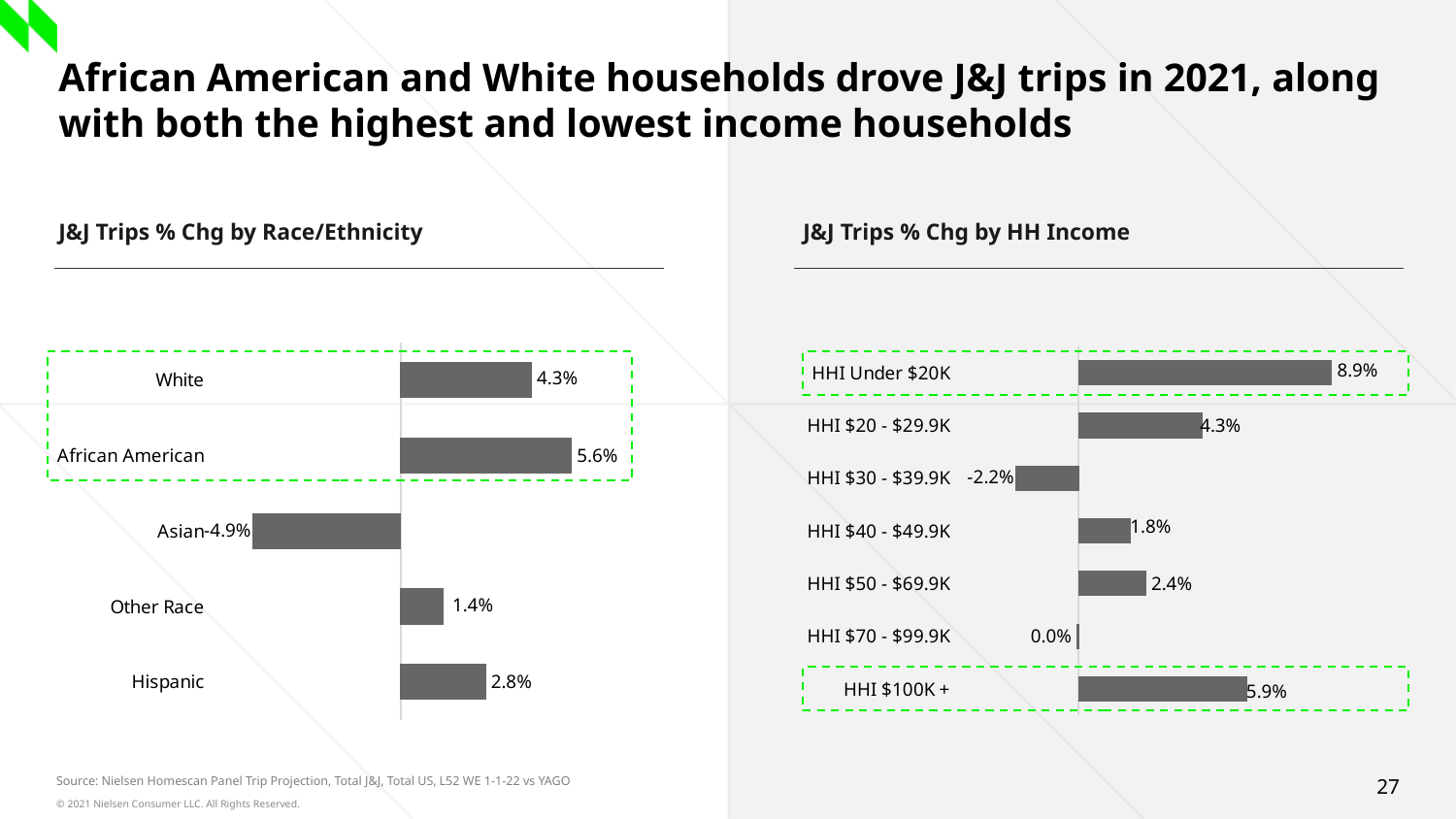
In the 'J&J Trips % Chg by HH Income' chart, which is larger, the value for HHI $50 - $69.9K or HHI $40 - $49.9K? HHI $50 - $69.9K In the 'J&J Trips % Chg by HH Income' chart, which category has the highest value? HHI Under $20K What type of chart is the 'J&J Trips % Chg by HH Income' chart? Bar chart In the 'J&J Trips % Chg by Race/Ethnicity' chart, what is the value for Asian? -4.9% In the 'J&J Trips % Chg by Race/Ethnicity' chart, what is the difference between the values for White and Hispanic? 1.5% In the 'J&J Trips % Chg by Race/Ethnicity' chart, which category has the highest value? African American In the 'J&J Trips % Chg by HH Income' chart, what is the value for HHI Under $20K? 8.9% In the 'J&J Trips % Chg by Race/Ethnicity' chart, which category has the lowest value? Asian In the 'J&J Trips % Chg by Race/Ethnicity' chart, what is the value for African American? 5.6% In the 'J&J Trips % Chg by HH Income' chart, how many income categories are shown? 7 In the 'J&J Trips % Chg by HH Income' chart, what is the value for HHI $30 - $39.9K? -2.2% In the 'J&J Trips % Chg by Race/Ethnicity' chart, how many categories are shown? 5